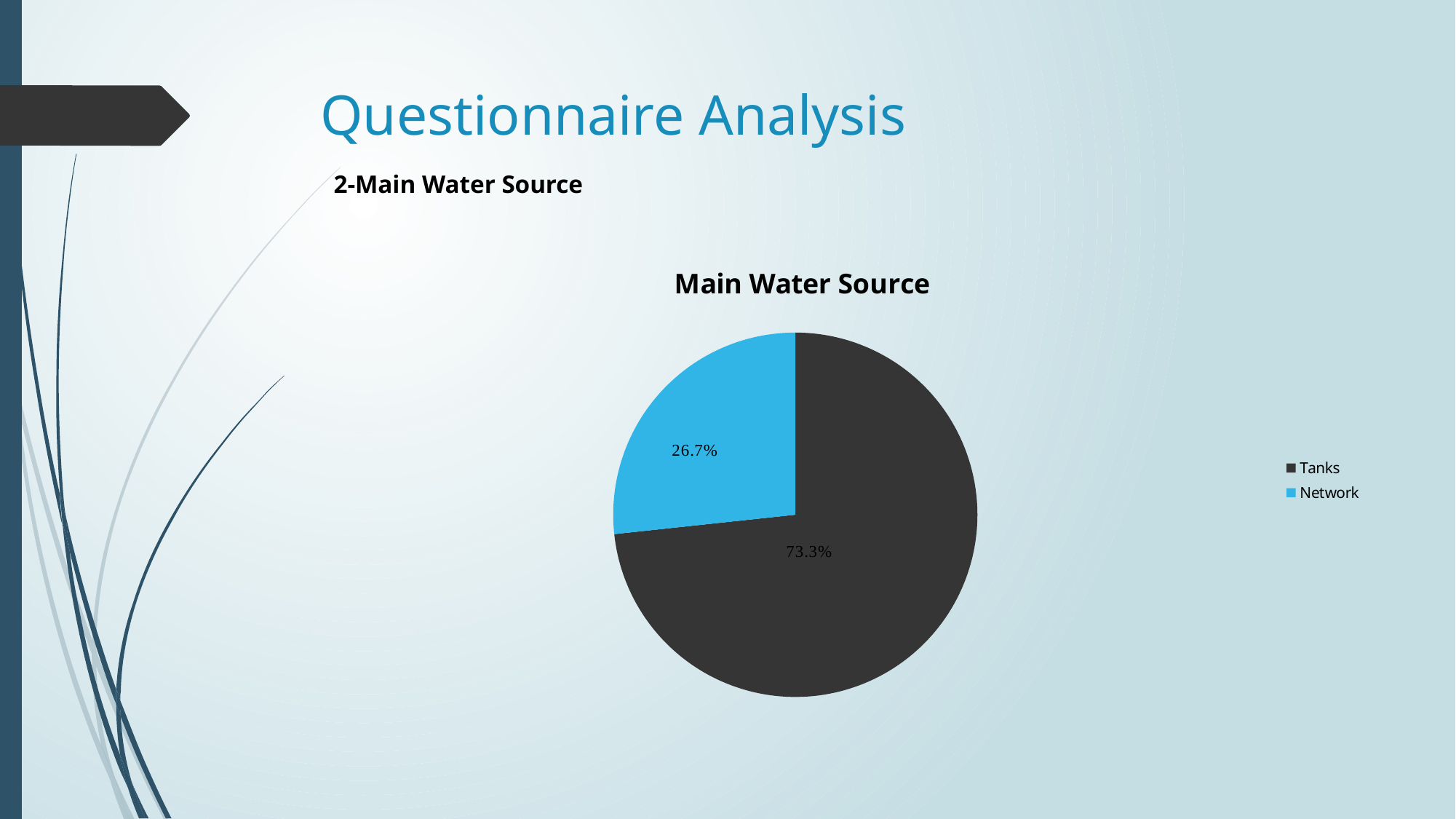
Which is larger, the share for Tanks or the share for Network? Tanks What percentage of the pie is Tanks? 73.3% How many slices does the pie chart have? 2 Which category has the largest share of the pie? Tanks Which category has the smallest share of the pie? Network What kind of chart is shown on the slide? pie chart What share of the pie does the Tanks slice represent? 73.3% What colour is the Network slice? light blue What is the difference in percentage points between Tanks and Network? 46.6 What is the title of the chart? Main Water Source What percentage of the pie is Network? 26.7% How many entries does the legend list? 2